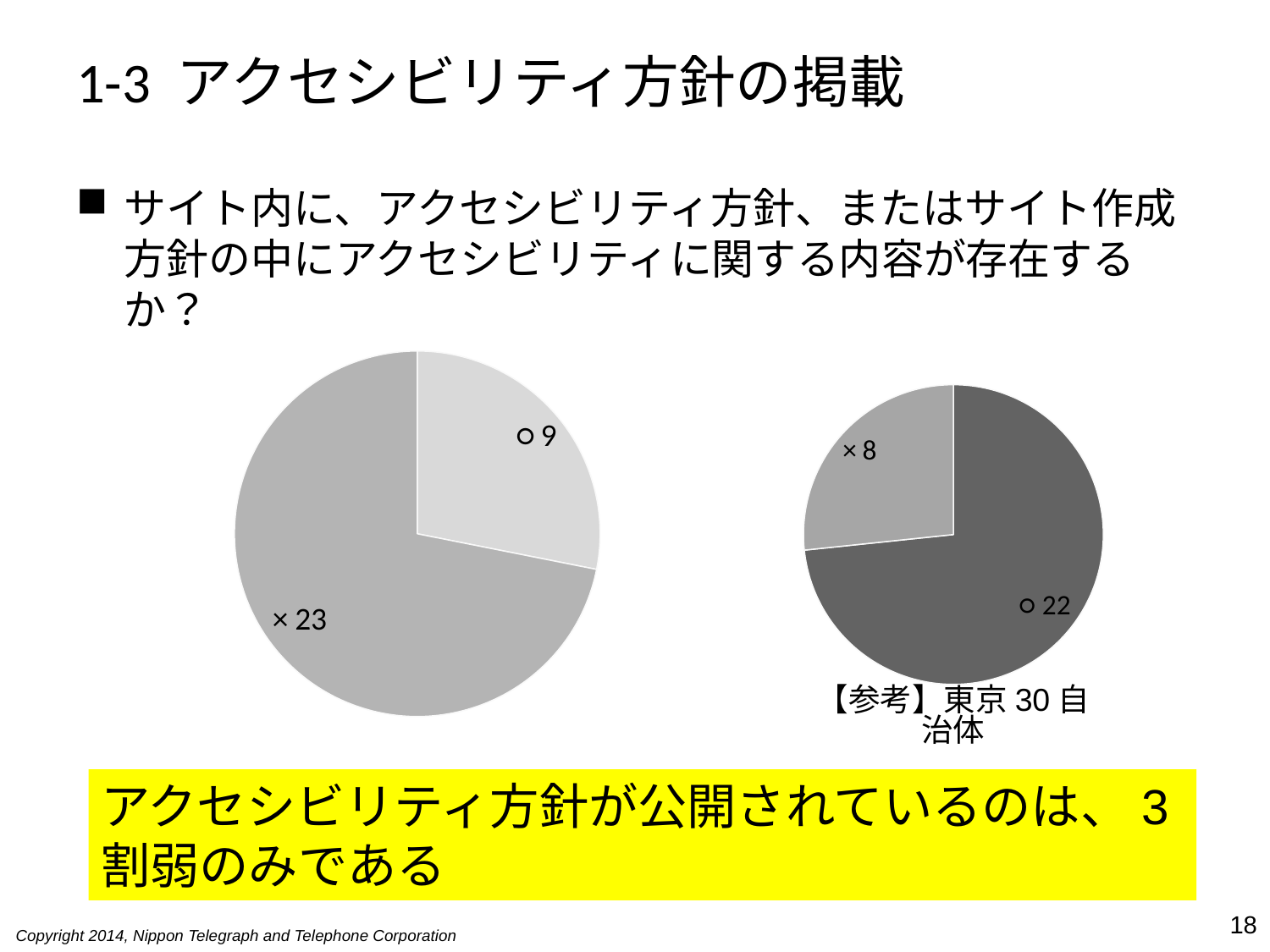
In the right pie chart (【参考】東京30自治体), what is the difference between the ○ value and the × value? 14 In the left pie chart, what is the difference between the × value and the ○ value? 14 How many slices does the left pie chart have? 2 Which is larger: the ○ value in the left pie chart or the ○ value in the right pie chart? The right pie chart (22) In the left pie chart, what is the total of the two slices? 32 In the left pie chart, what is the value for the ○ slice? 9 In the right pie chart (【参考】東京30自治体), which slice is the smallest? × What kind of chart is used on this slide? Pie chart In the right pie chart (【参考】東京30自治体), what is the value for the ○ slice? 22 In the left pie chart, which slice is the largest? × In the left pie chart, what is the value for the × slice? 23 In the right pie chart (【参考】東京30自治体), what is the value for the × slice? 8